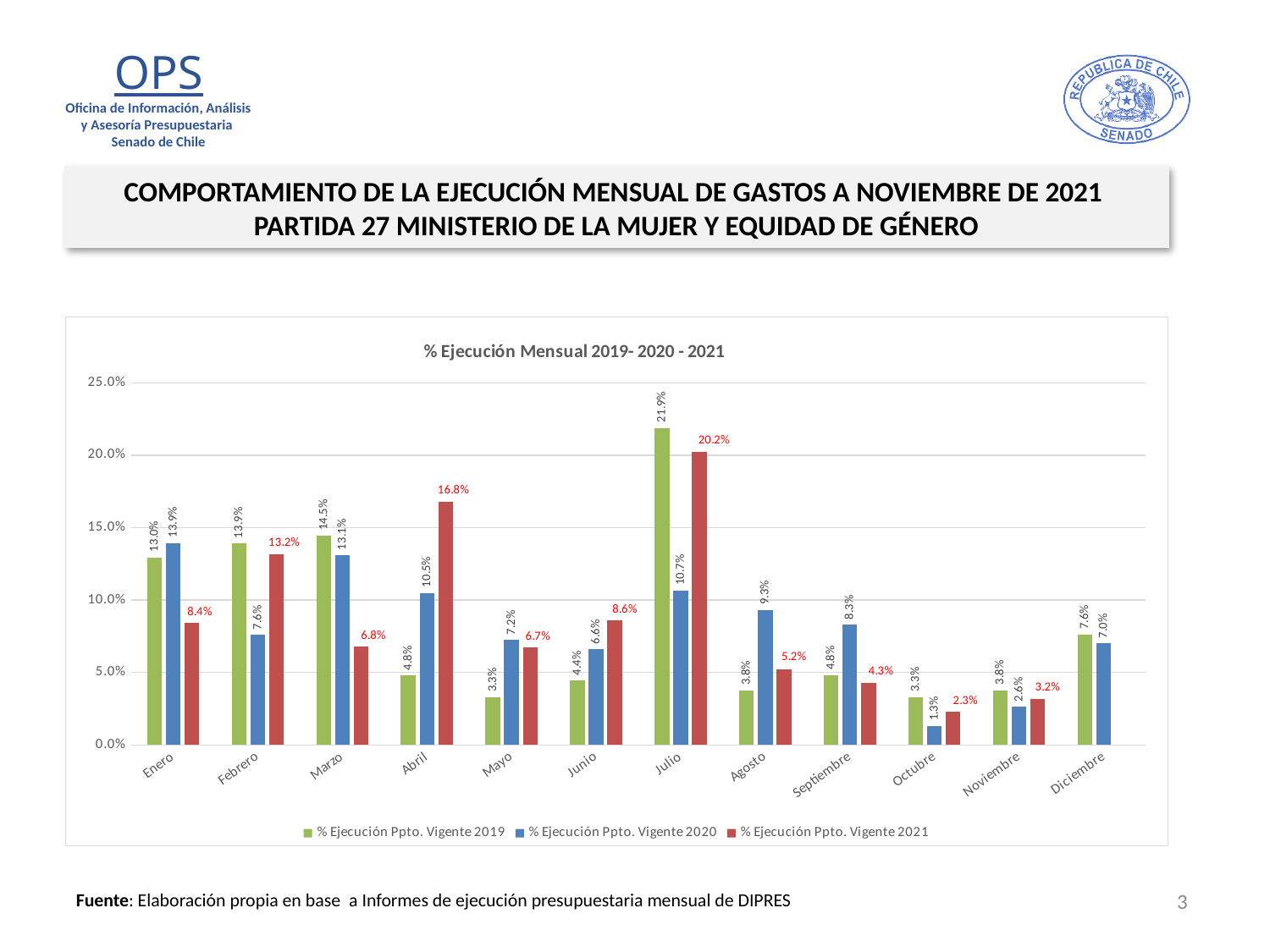
Is the value for Marzo in the 2019 series greater or less than 10.0%? greater What is the value for Octubre in the % Ejecución Ppto. Vigente 2020 series? 1.3% What is the difference between the 2019 and 2021 values for Julio? 1.7% What is the value for Abril in the % Ejecución Ppto. Vigente 2021 series? 16.8% What kind of chart is shown? Bar chart How many months are shown on the x axis? 12 What is the title of the chart? % Ejecución Mensual 2019- 2020 - 2021 What is the value for Julio in the % Ejecución Ppto. Vigente 2019 series? 21.9% How many series does the legend list? 3 Which month has the highest value in the % Ejecución Ppto. Vigente 2021 series? Julio Which is larger for Febrero: the 2020 value or the 2021 value? 2021 value (13.2%) Which month has the lowest value in the % Ejecución Ppto. Vigente 2020 series? Octubre